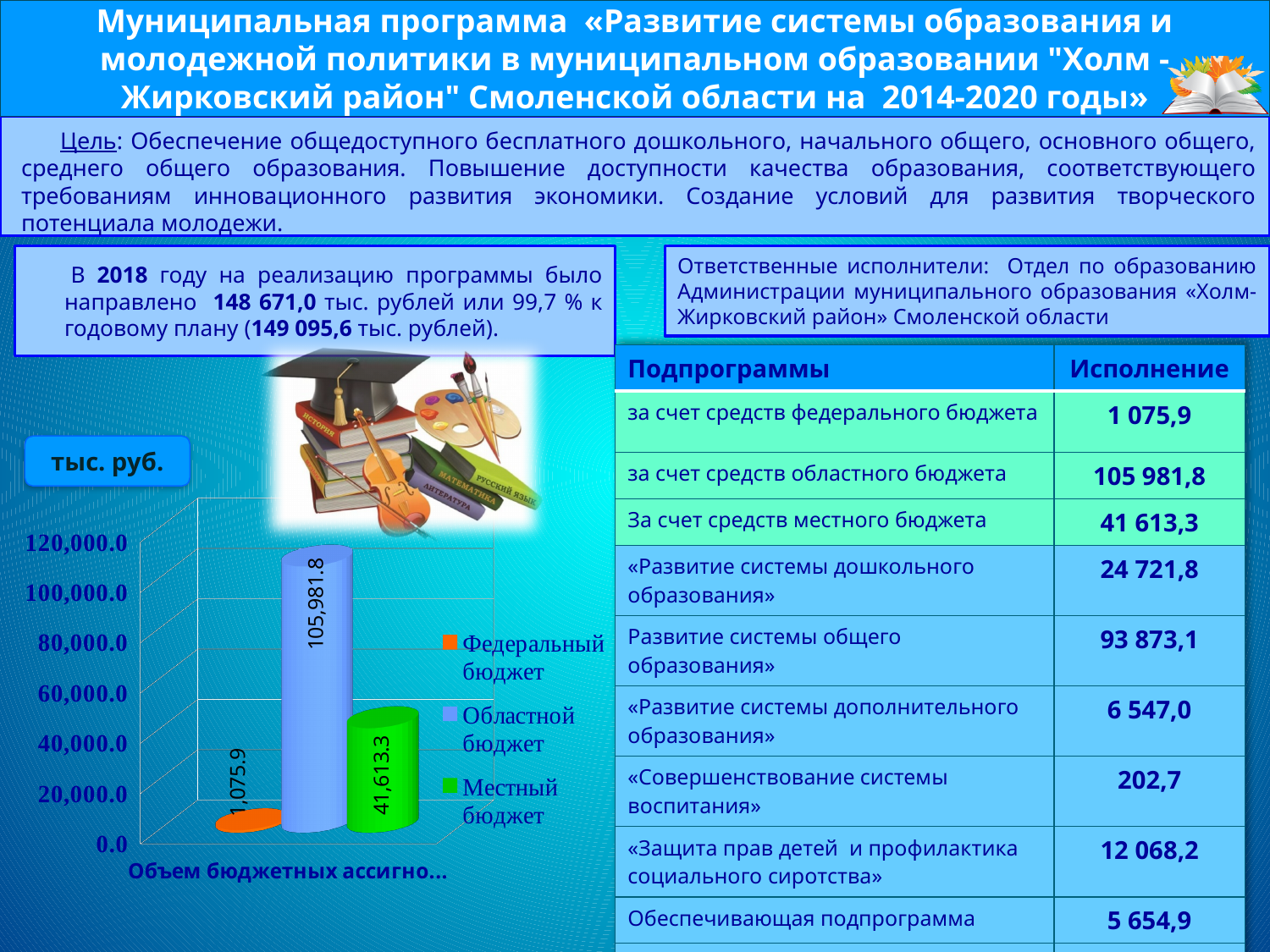
Which series has the highest value in the chart? Областной бюджет Which is larger, the value for Местный бюджет or the value for Федеральный бюджет? Местный бюджет What colour is the bar for Местный бюджет in the chart? green What is the value for Областной бюджет in the chart? 105,981.8 What is the value for Федеральный бюджет in the chart? 1,075.9 How many series does the chart legend list? 3 What is the difference between the values for Местный бюджет and Федеральный бюджет? 40,537.4 What is the difference between the values for Областной бюджет and Местный бюджет? 64,368.5 Which series has the lowest value in the chart? Федеральный бюджет Is the value for Областной бюджет greater or less than 100,000.0? greater What is the value for Местный бюджет in the chart? 41,613.3 What type of chart is shown on the slide? bar chart